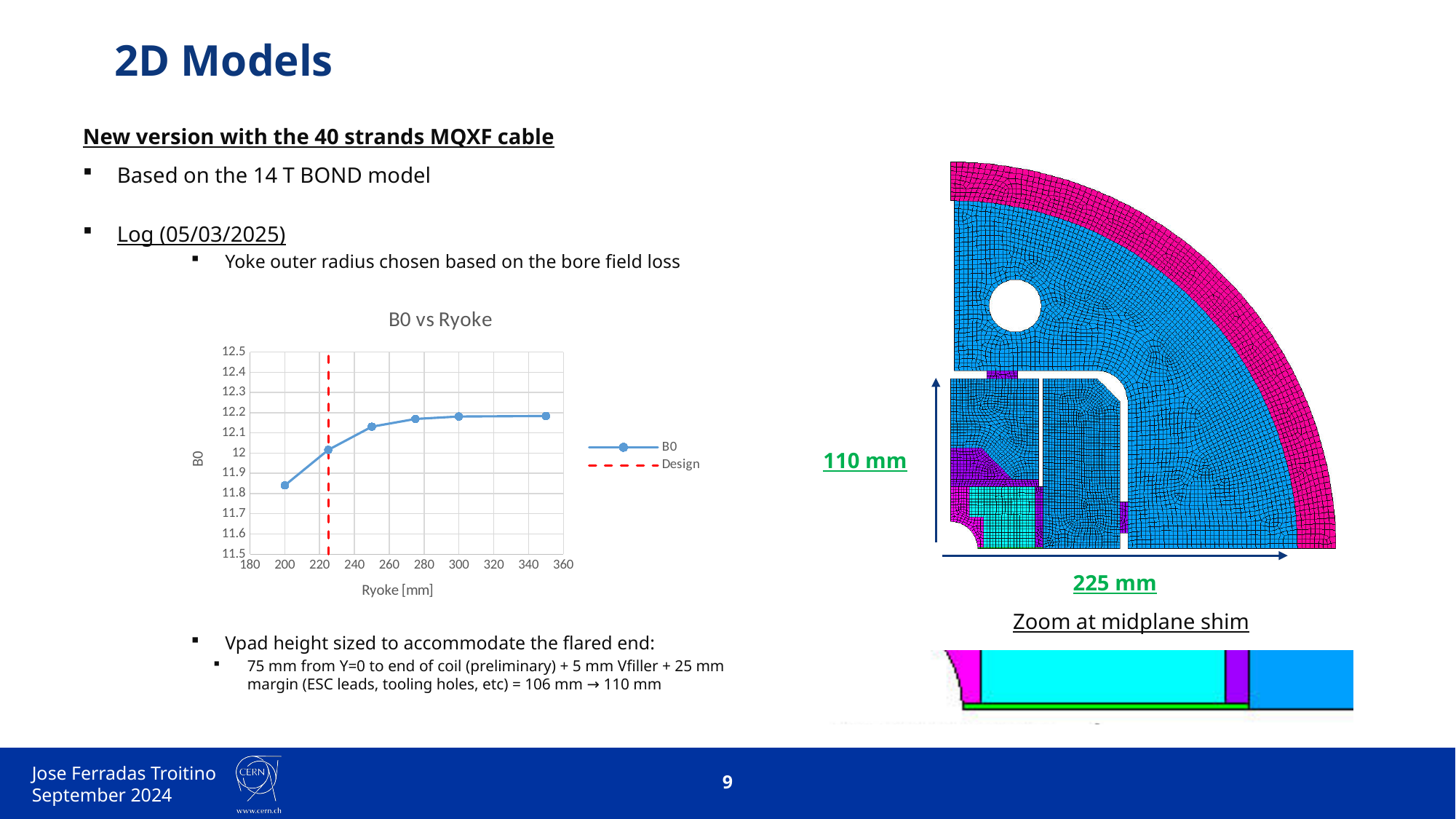
How many data points are plotted on the B0 line in the B0 vs Ryoke chart? 6 In the B0 vs Ryoke chart, is the B0 value at Ryoke = 300 mm greater or less than 12.1? greater In the B0 vs Ryoke chart, which has the larger B0 value: Ryoke = 200 mm or Ryoke = 300 mm? Ryoke = 300 mm What is the label of the x axis in the B0 vs Ryoke chart? Ryoke [mm] What is the title of the chart on the slide? B0 vs Ryoke In the B0 vs Ryoke chart, does B0 rise or fall as Ryoke increases? rises What kind of chart is the B0 vs Ryoke chart? line chart In the B0 vs Ryoke chart, at which Ryoke value is B0 lowest? 200 In the B0 vs Ryoke chart, is the B0 value at Ryoke = 200 mm greater or less than 12? less In the B0 vs Ryoke chart, is the B0 value at Ryoke = 225 mm greater or less than 11.9? greater How many series does the legend of the B0 vs Ryoke chart list? 2